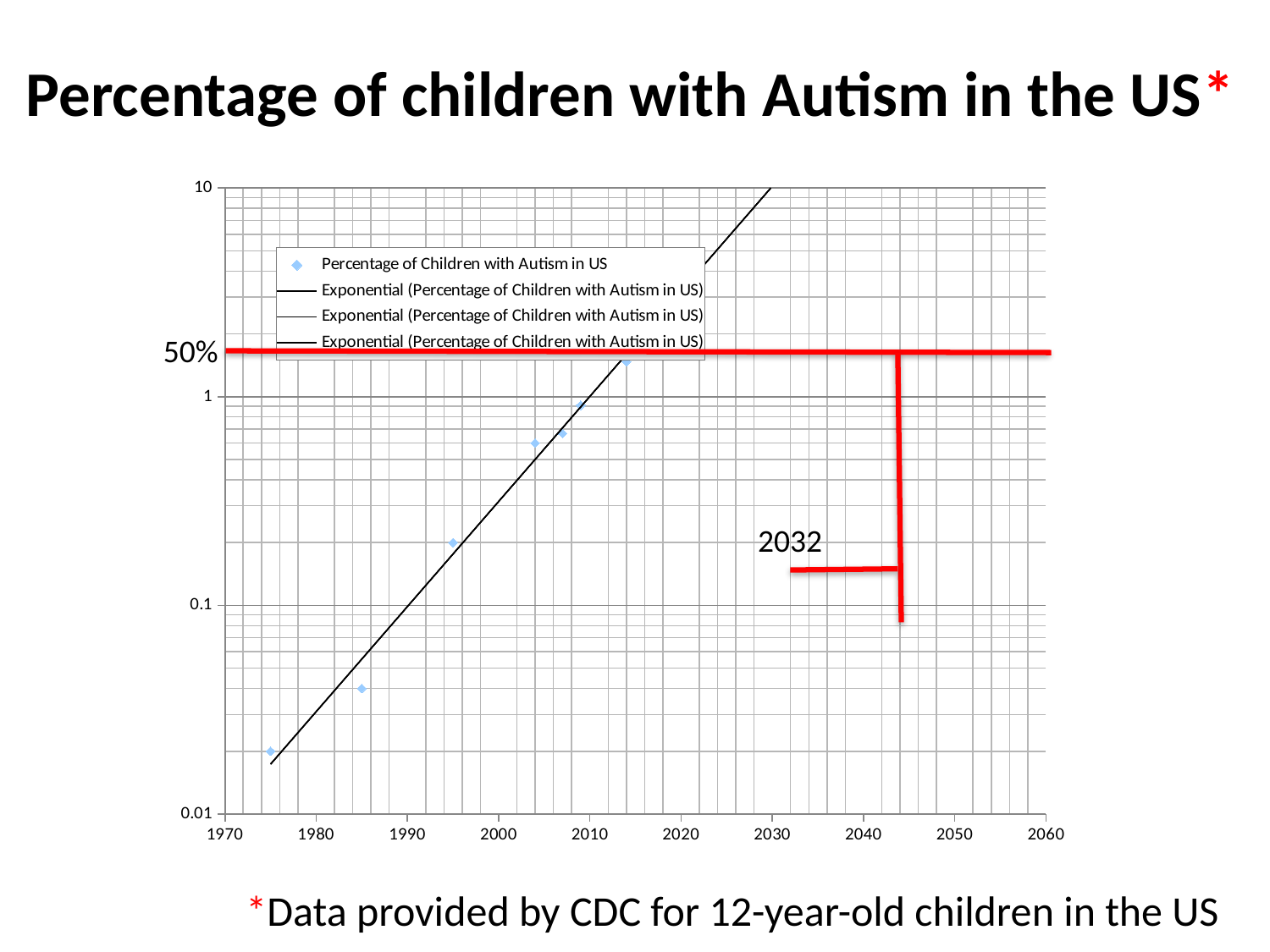
Is the plotted value for 1975 greater or less than 0.1? less How many entries does the chart legend list? 4 Is the plotted value for 2014 greater or less than 1? greater Which has the larger plotted value, 1985 or 1995? 1995 How many data points are plotted on the chart? 7 Which year has the lowest plotted value? 1975 What percentage label is written beside the horizontal red line on the chart? 50% Which year has the highest plotted value? 2014 What year is written next to the red annotation lines on the chart? 2032 Do the plotted values rise or fall as the year increases along the x axis? Rise What kind of chart is shown on the slide? Scatter chart Is the plotted value for 1995 greater or less than 1? less